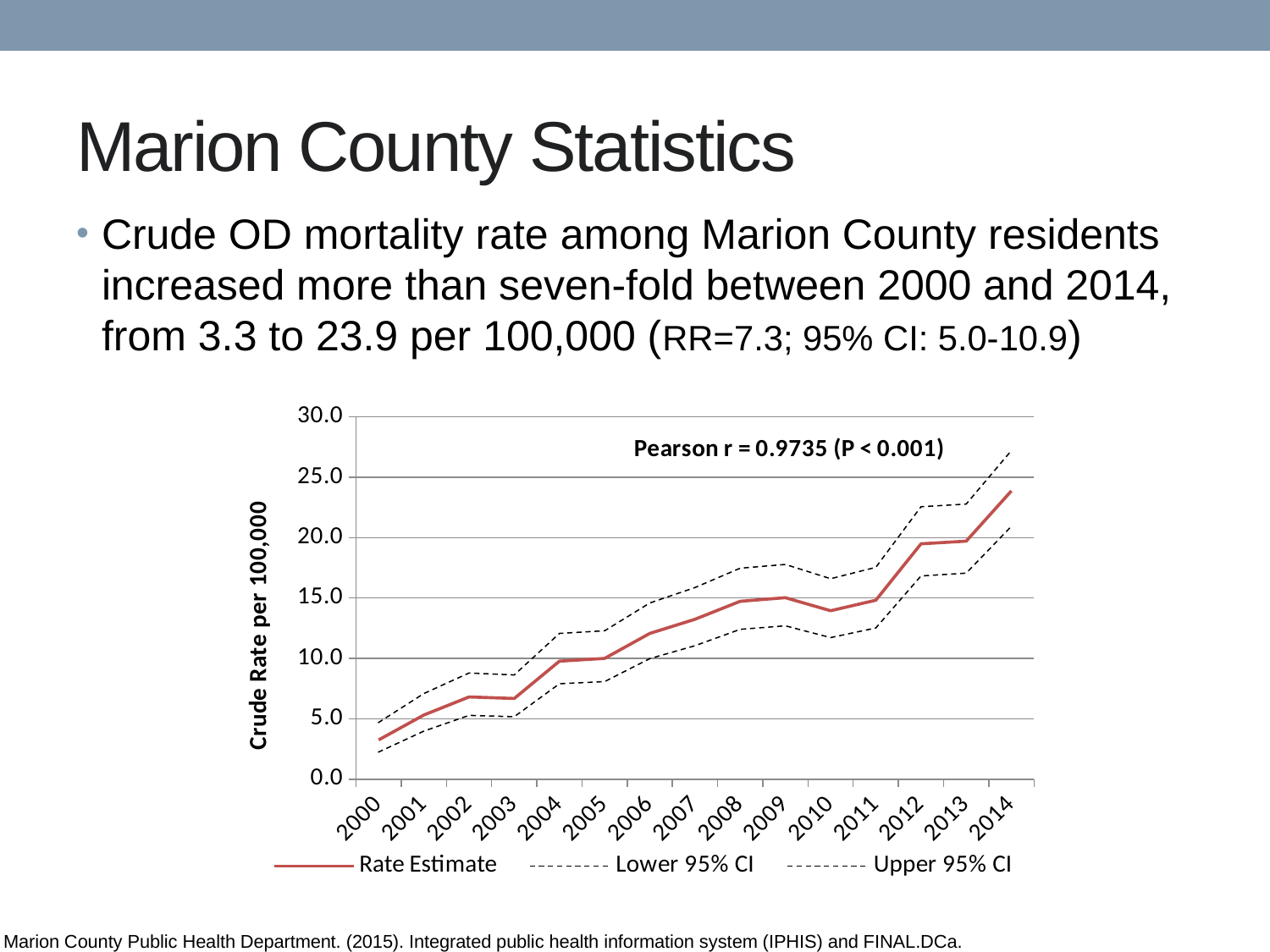
What is the crude OD mortality rate per 100,000 for Marion County in 2014? 23.9 Is the Rate Estimate for 2012 greater or less than 20.0? less In which year is the Rate Estimate highest? 2014 How many series does the chart legend list? 3 What Pearson r value is printed on the chart? 0.9735 In which year is the Rate Estimate lowest? 2000 By how much did the crude OD mortality rate per 100,000 increase between 2000 and 2014? 20.6 Does the Rate Estimate generally rise or fall from 2000 to 2014? rise Is the Upper 95% CI value for 2014 greater or less than 25.0? greater How many years are plotted along the x axis of the chart? 15 What kind of chart is shown on the slide? line chart What is the crude OD mortality rate per 100,000 for Marion County in 2000? 3.3